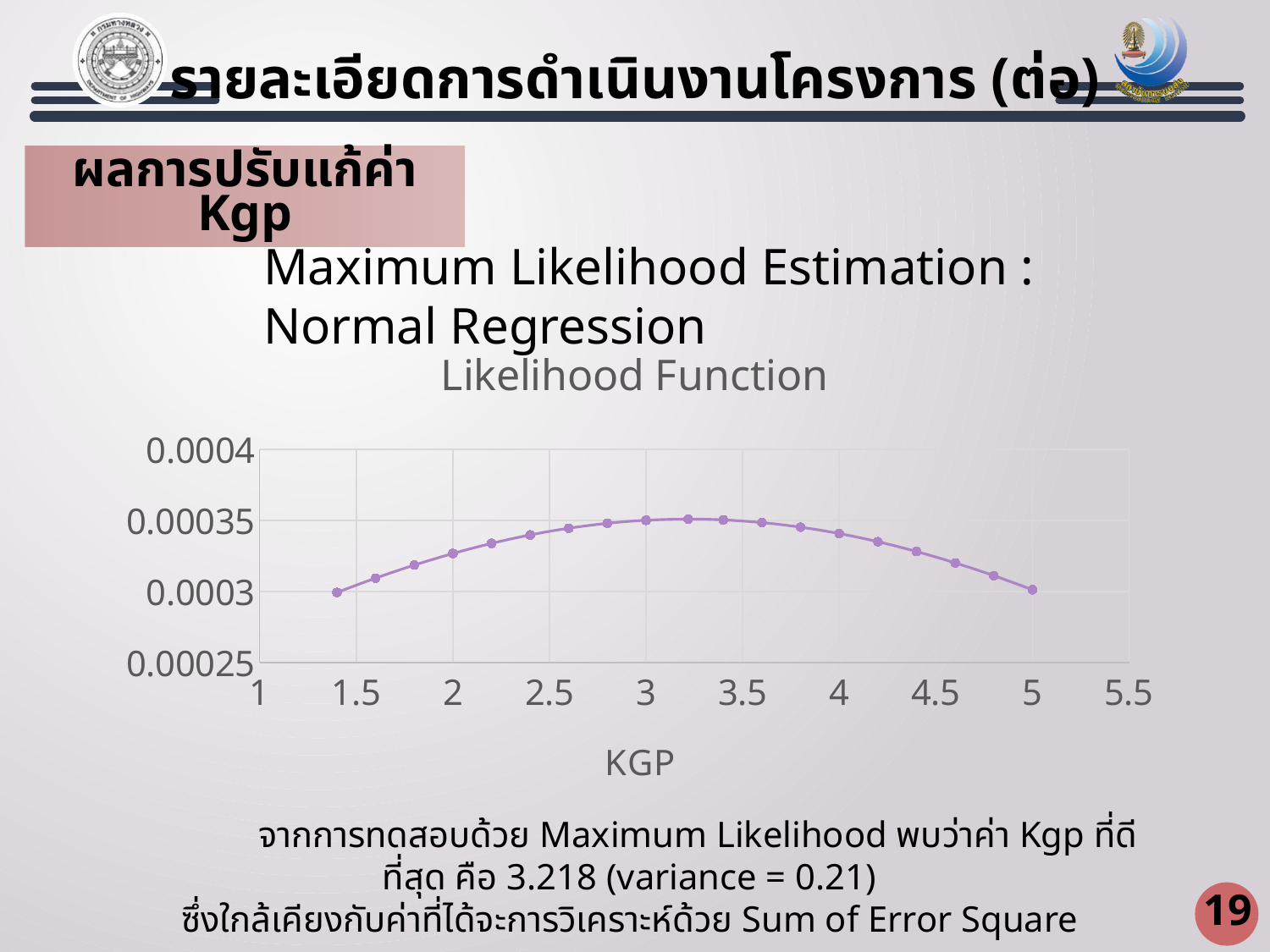
What kind of chart is shown on the slide? line chart Which has the larger likelihood value, KGP 3 or KGP 4.6? KGP 3 Is the likelihood value at KGP 5 greater or less than 0.00035? less What is the label of the x axis of the chart? KGP Is the likelihood value at KGP 3.2 greater or less than 0.0004? less Is the likelihood value at KGP 2 greater or less than 0.00035? less What is the highest value shown on the y axis of the chart? 0.0004 How many data points are plotted on the line? 19 Which has the larger likelihood value, KGP 2 or KGP 5? KGP 2 How does the likelihood value change as KGP increases from 1.4 to 5? rises to a peak then falls What is the title of the chart? Likelihood Function